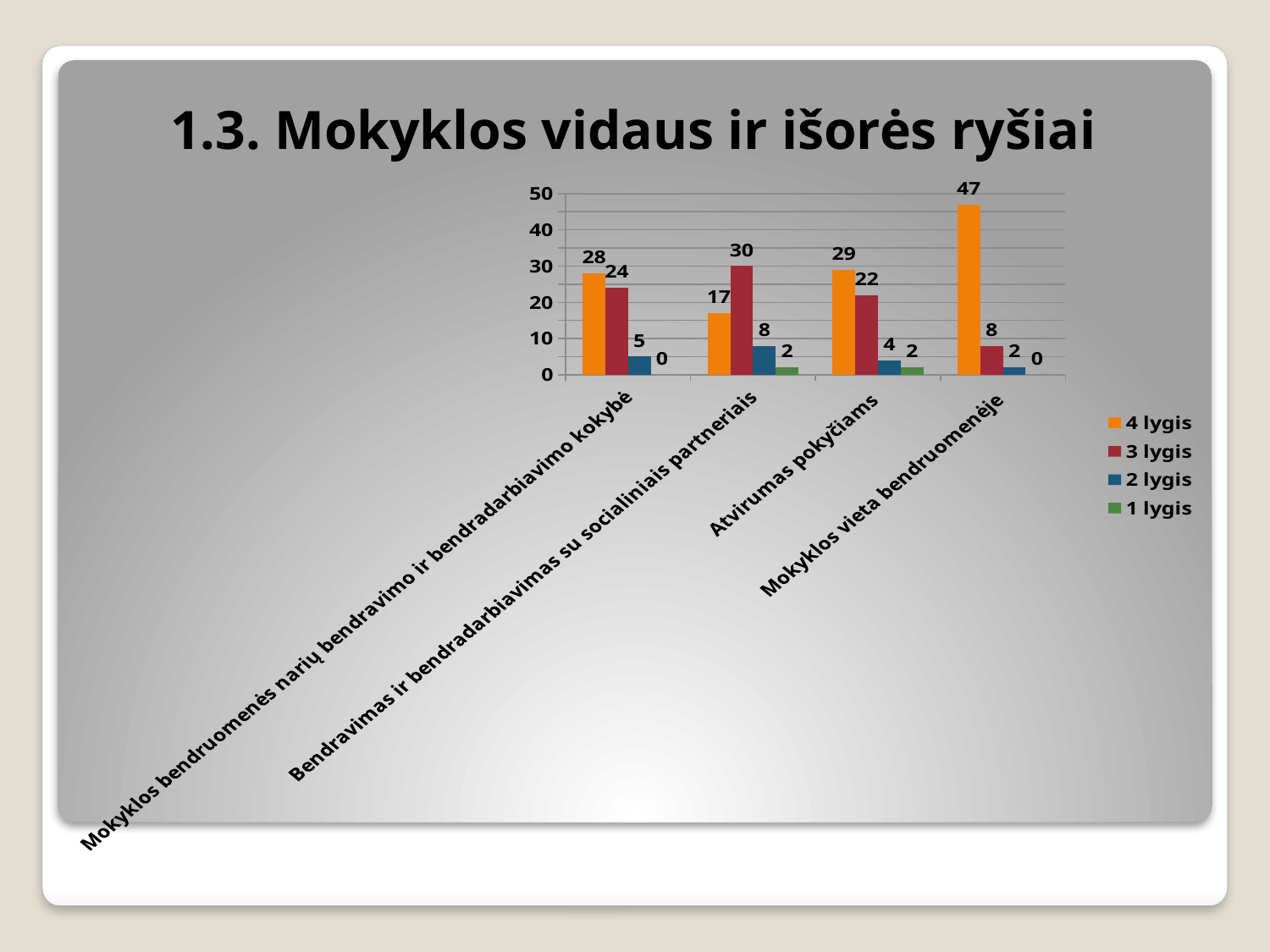
Which category has the lowest '4 lygis' value? Bendravimas ir bendradarbiavimas su socialiniais partneriais For 'Atvirumas pokyčiams', which is larger: the '4 lygis' value or the '3 lygis' value? 4 lygis What type of chart is shown on the slide? bar chart What is the value of '4 lygis' for 'Mokyklos vieta bendruomenėje'? 47 What is the difference between the '4 lygis' and '3 lygis' values for 'Mokyklos vieta bendruomenėje'? 39 What is the value of '3 lygis' for 'Bendravimas ir bendradarbiavimas su socialiniais partneriais'? 30 Which category has the highest '4 lygis' value? Mokyklos vieta bendruomenėje What is the value of '2 lygis' for 'Mokyklos bendruomenės narių bendravimo ir bendradarbiavimo kokybė'? 5 Which legend entry is shown in green? 1 lygis Is the '4 lygis' value for 'Mokyklos vieta bendruomenėje' greater or less than 40? greater How many series does the legend list? 4 How many categories are shown on the x axis? 4